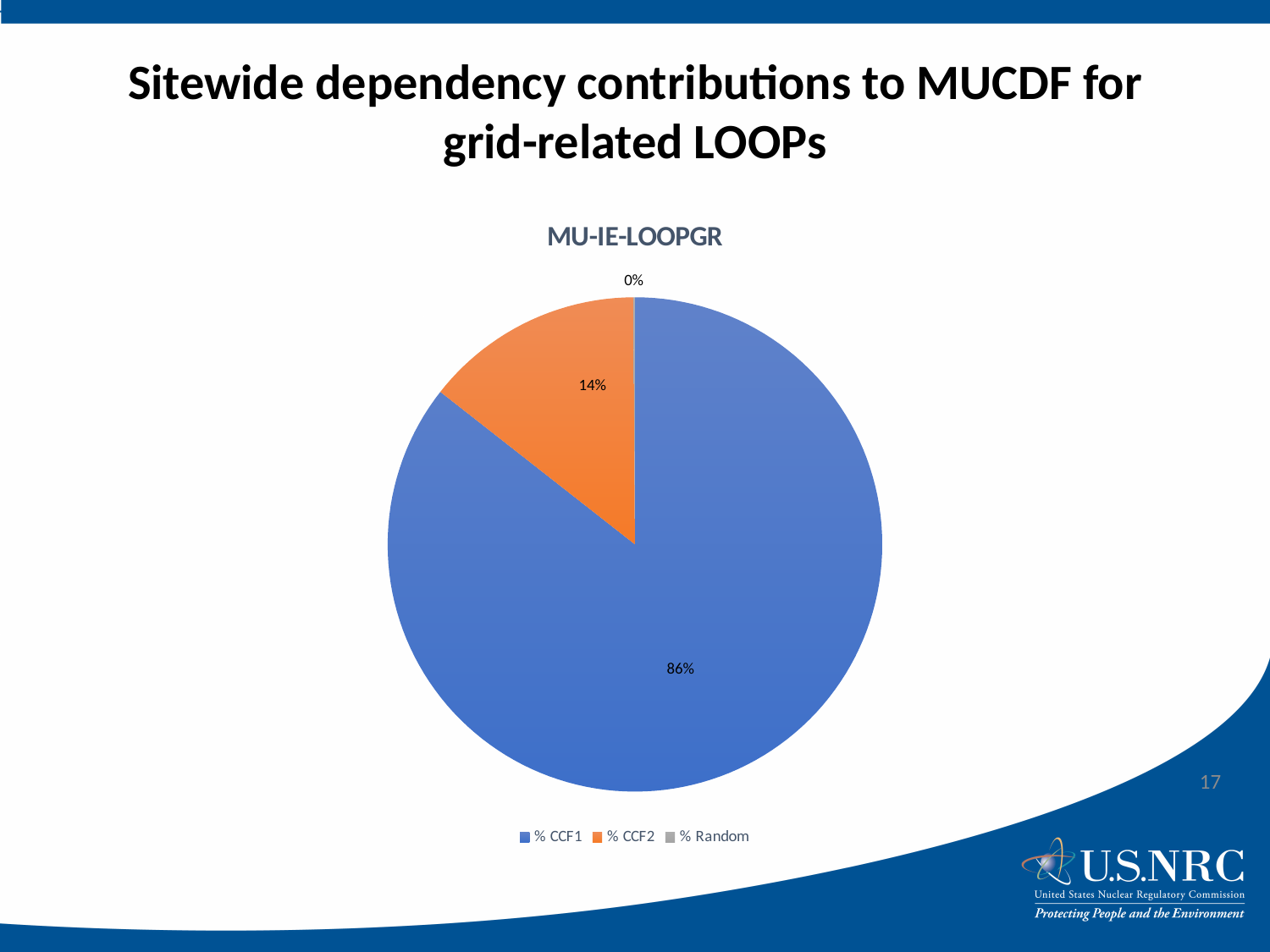
What kind of chart is shown on the slide? pie chart What share of the pie does % CCF1 take? 86% What is the difference in percentage points between the % CCF1 and % CCF2 slices? 72 What is the chart's title? MU-IE-LOOPGR What share of the pie does % Random take? 0% Which category has the smallest slice of the pie? % Random How many categories does the legend list? 3 Which is larger, the % CCF1 slice or the % CCF2 slice? % CCF1 Which category has the largest slice of the pie? % CCF1 What colour is the % CCF2 slice? orange What share of the pie does % CCF2 take? 14%